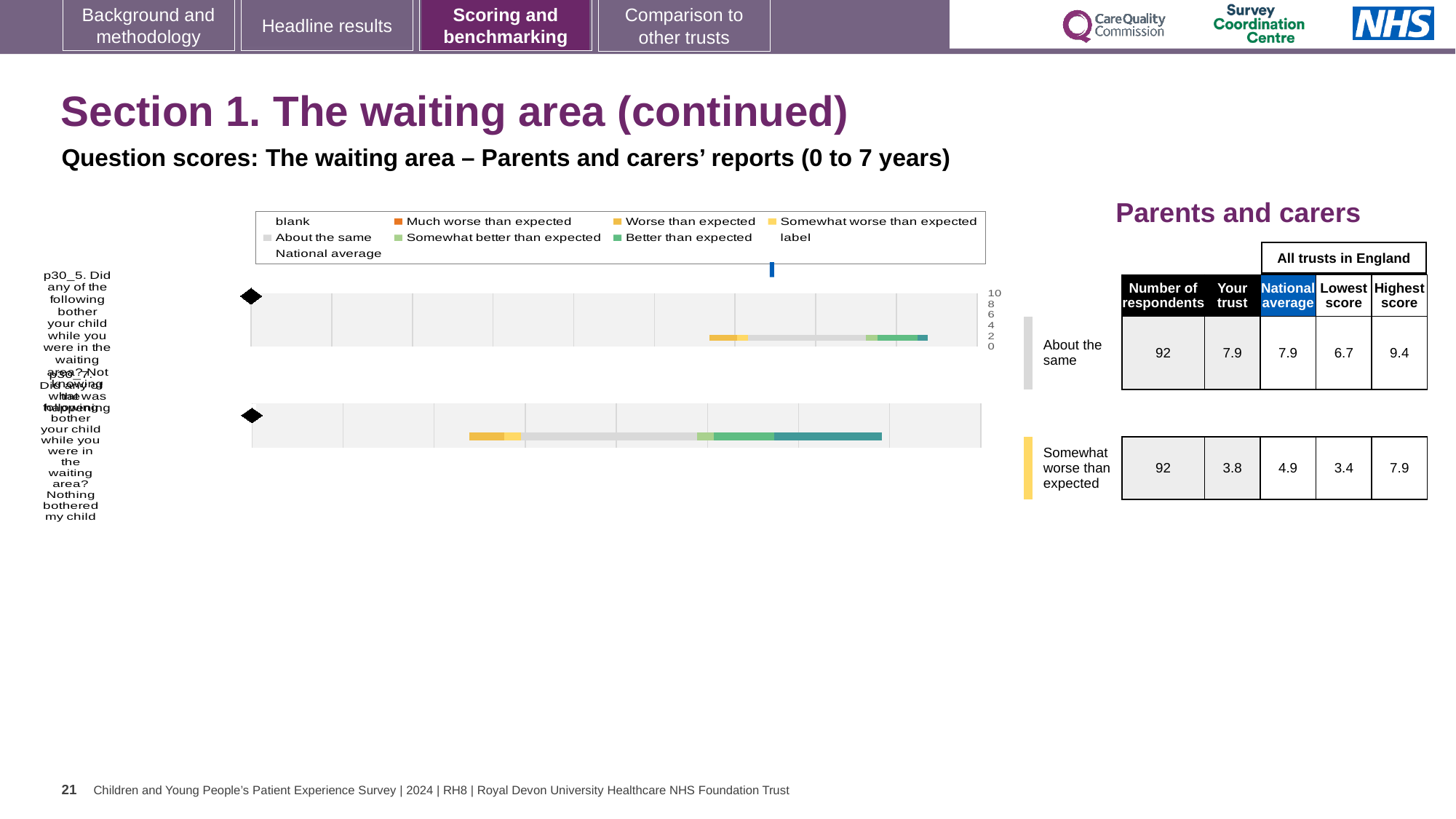
According to the table, what is the 'Your trust' score for the question about not knowing what was happening (p30_5)? 7.9 What is the difference between the trust's score for p30_5 (7.9) and for p30_7 (3.8)? 4.1 How many respondents answered each of the two questions? 92 How many entries does the chart legend list? 9 How many bars (questions) are plotted in the chart? 2 What is the national average for the question rated 'Somewhat worse than expected'? 4.9 What is the highest score across all trusts in England for the question rated 'About the same'? 9.4 What kind of chart is shown on the slide? bar chart Which question has the higher 'Your trust' score, p30_5 or p30_7? p30_5 According to the table, what is the 'Your trust' score for the question about nothing bothering the child in the waiting area (p30_7)? 3.8 Which legend entry is shown in orange? Much worse than expected What is the highest value shown on the chart's axis? 10